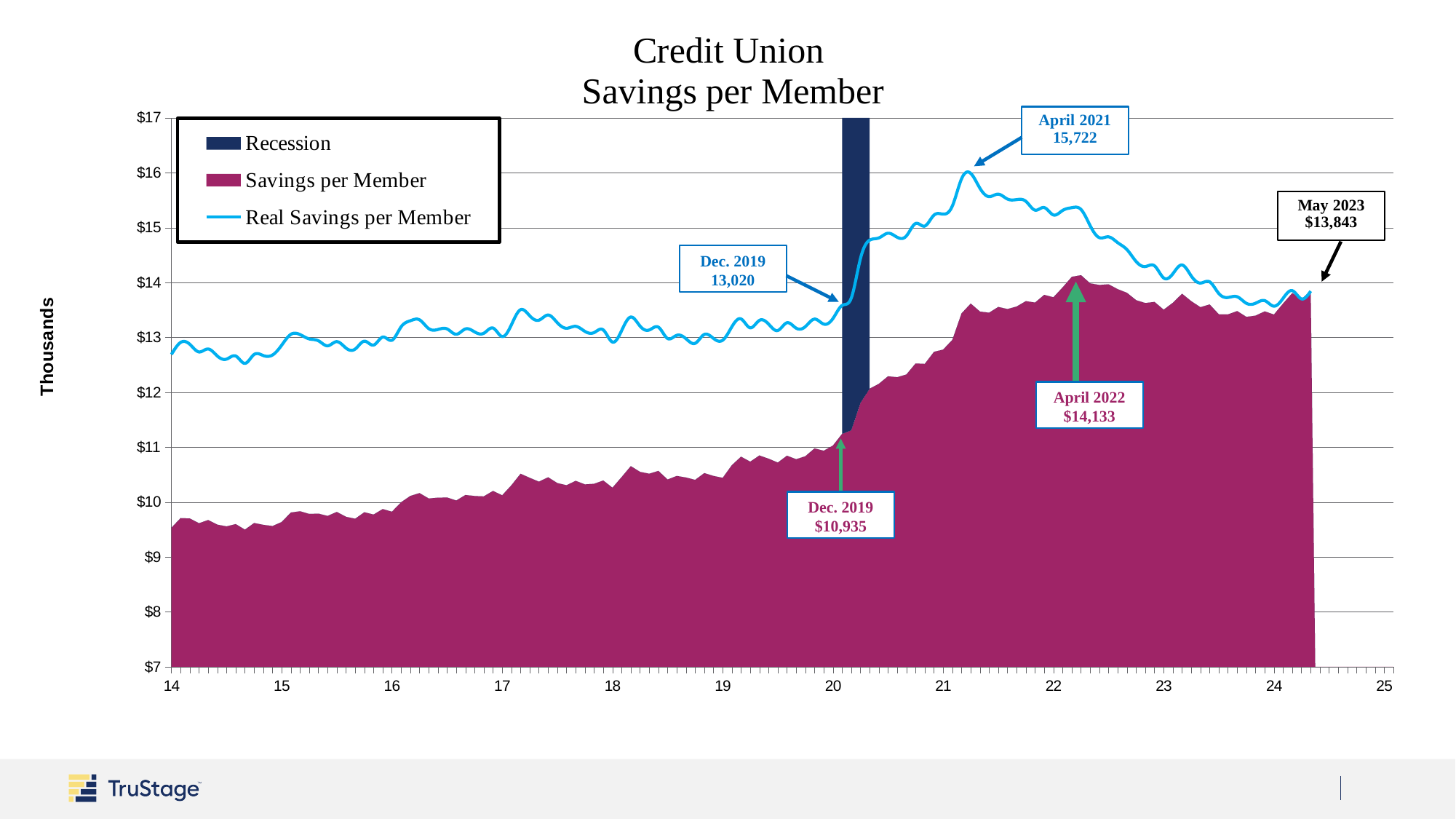
What was Real Savings per Member in April 2021, according to the annotation? 15,722 By how much did Savings per Member increase from Dec. 2019 to April 2022, using the annotated values? $3,198 What was Savings per Member in April 2022, according to the annotation? $14,133 What was Real Savings per Member in Dec. 2019, according to the annotation? 13,020 In Dec. 2019, which was larger: Real Savings per Member or Savings per Member? Real Savings per Member Does Savings per Member generally rise or fall from 2014 to 2022? Rise Is the Savings per Member value at the start of 2014 greater or less than $10? less What was Savings per Member in Dec. 2019, according to the annotation? $10,935 How many entries does the chart legend list? 3 What value is shown in the May 2023 annotation? $13,843 What is the title of the chart? Credit Union Savings per Member What kind of chart is used to plot the Real Savings per Member series? Line chart